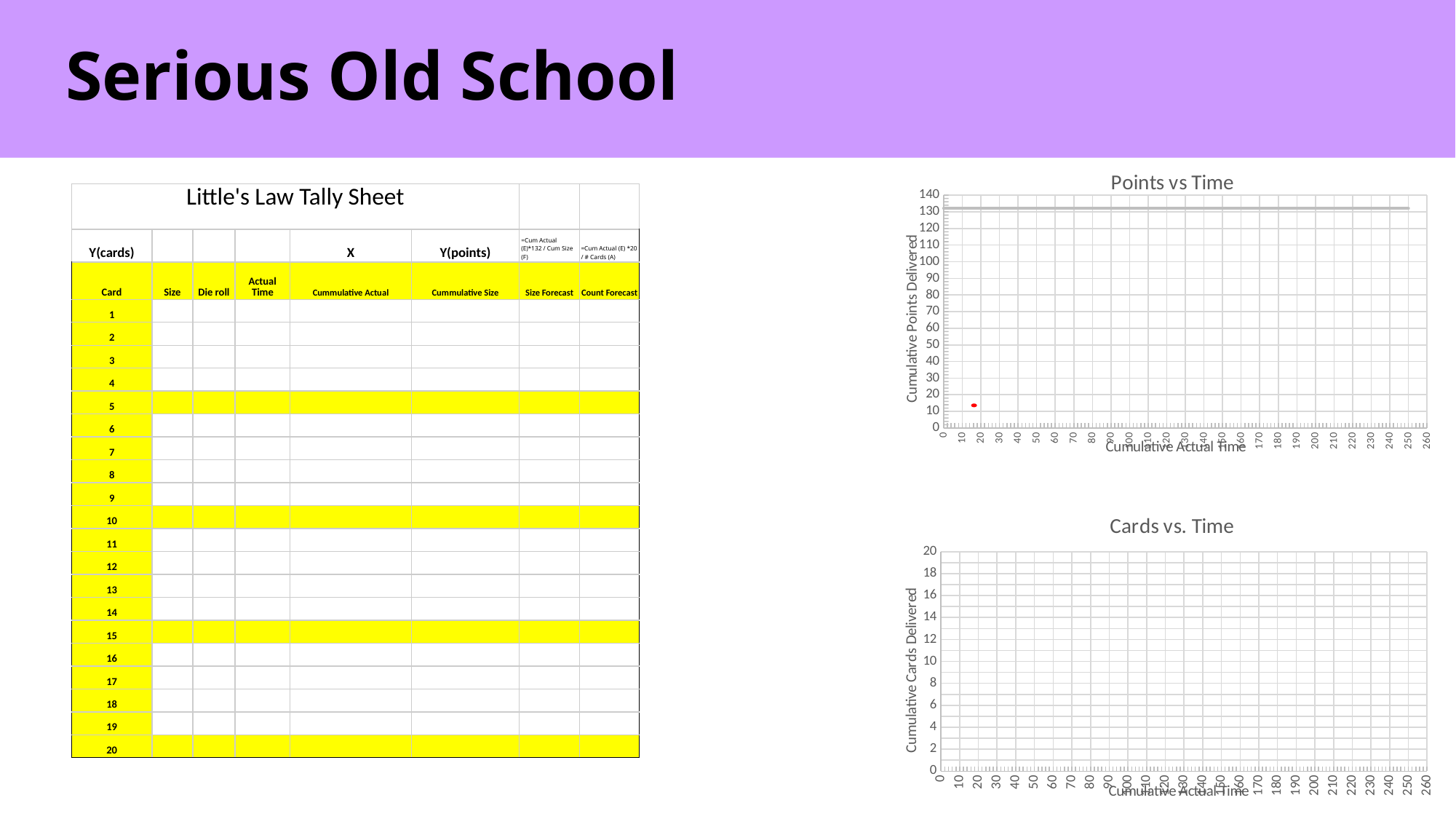
What is the highest tick value shown on the horizontal axis of the Cards vs. Time chart? 260 What is the title of the upper chart on the right side of the slide? Points vs Time What is the highest tick value shown on the vertical axis of the Cards vs. Time chart? 20 In the Points vs Time chart, is the red data point's horizontal position greater or less than 30 on the Cumulative Actual Time axis? less What is the title of the lower chart on the right side of the slide? Cards vs. Time What is the highest tick value shown on the vertical axis of the Points vs Time chart? 140 In the Points vs Time chart, is the value of the red data point greater or less than 20 on the vertical axis? less In the Points vs Time chart, how many red data points are plotted? 1 In the Points vs Time chart, is the horizontal gray line greater or less than 120 on the vertical axis? greater In the Cards vs. Time chart, how many data points are plotted? 0